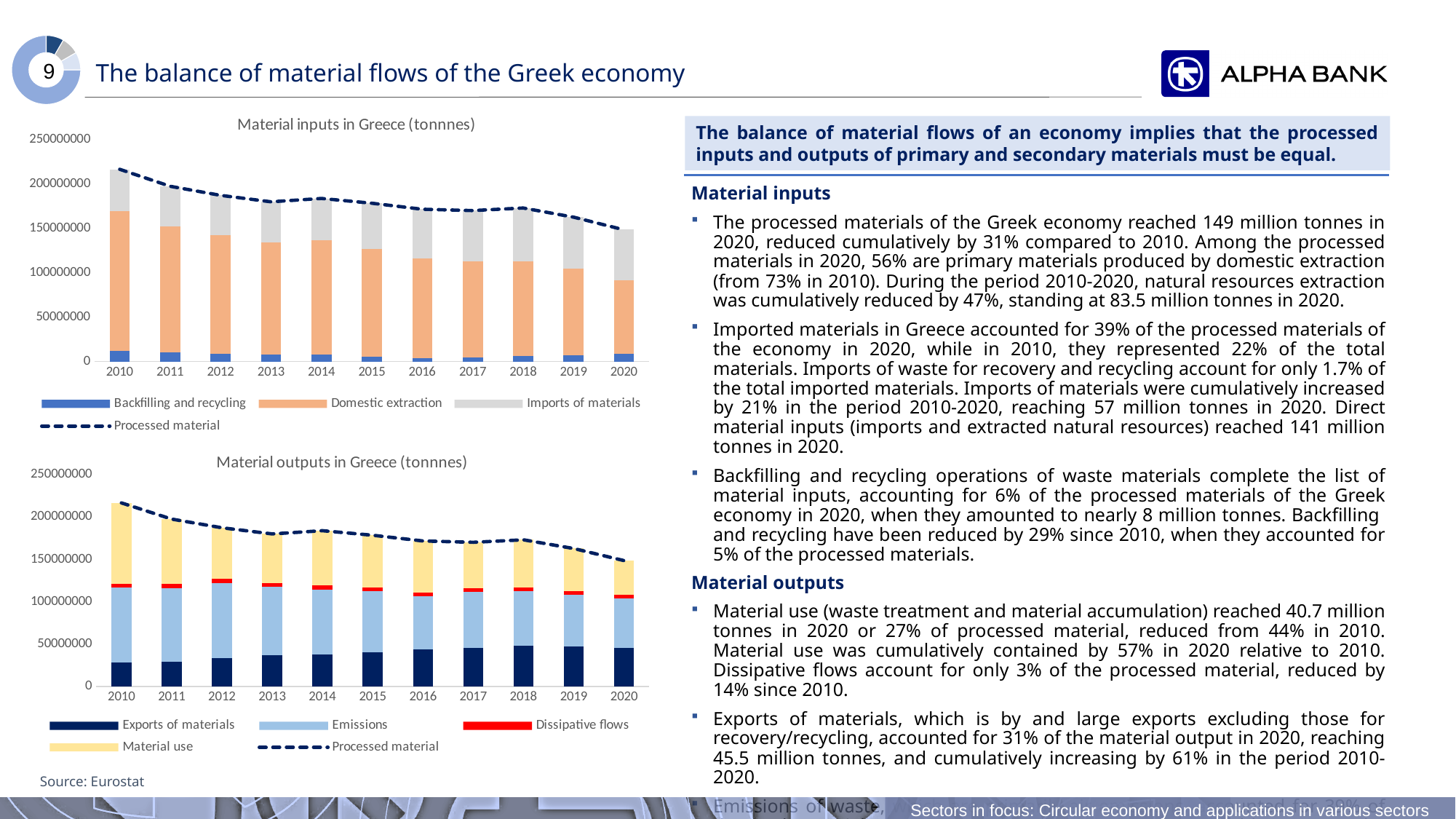
In the 'Material inputs in Greece (tonnnes)' chart, is the Domestic extraction value for 2010 greater or less than 150000000? greater What kind of chart is the 'Material inputs in Greece (tonnnes)' chart? Stacked bar chart with a line In the 'Material inputs in Greece (tonnnes)' chart, which year has the highest Domestic extraction value? 2010 How many years are shown on the x axis of the 'Material outputs in Greece (tonnnes)' chart? 11 In the 'Material outputs in Greece (tonnnes)' chart, is the Exports of materials value for 2020 greater or less than 50000000? less In the 'Material inputs in Greece (tonnnes)' chart, does the Processed material line generally rise or fall from 2010 to 2020? Fall In the 'Material inputs in Greece (tonnnes)' chart, is the Domestic extraction value for 2020 greater or less than 100000000? less In the 'Material outputs in Greece (tonnnes)' chart, which series is shown in red? Dissipative flows How many series does the legend of the 'Material outputs in Greece (tonnnes)' chart list? 5 How many series does the legend of the 'Material inputs in Greece (tonnnes)' chart list? 4